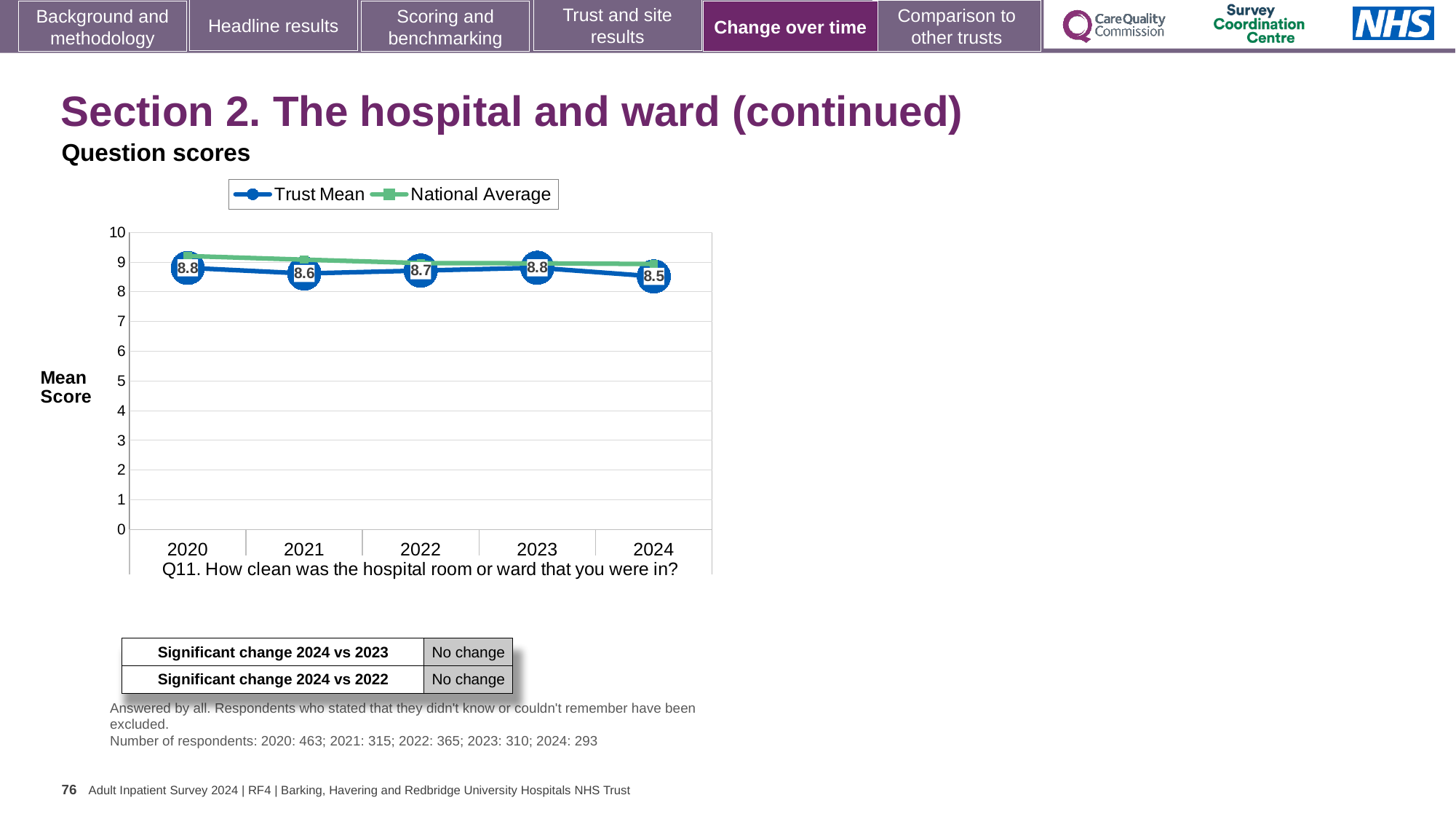
In which year is the Trust Mean lowest? 2024 Is the National Average for 2020 greater or less than 9? greater What is the difference between the Trust Mean in 2023 and in 2024? 0.3 What is the Trust Mean score for 2022? 8.7 How many years are plotted on the x axis? 5 How many series does the legend list? 2 What is the Trust Mean score for 2024 in the Q11 chart? 8.5 What is the Trust Mean score for 2021? 8.6 Does the Trust Mean rise or fall from 2023 to 2024? fall Which is larger, the Trust Mean for 2021 or for 2024? 2021 Is the National Average for 2024 greater or less than 8? greater What kind of chart is shown on the slide? line chart